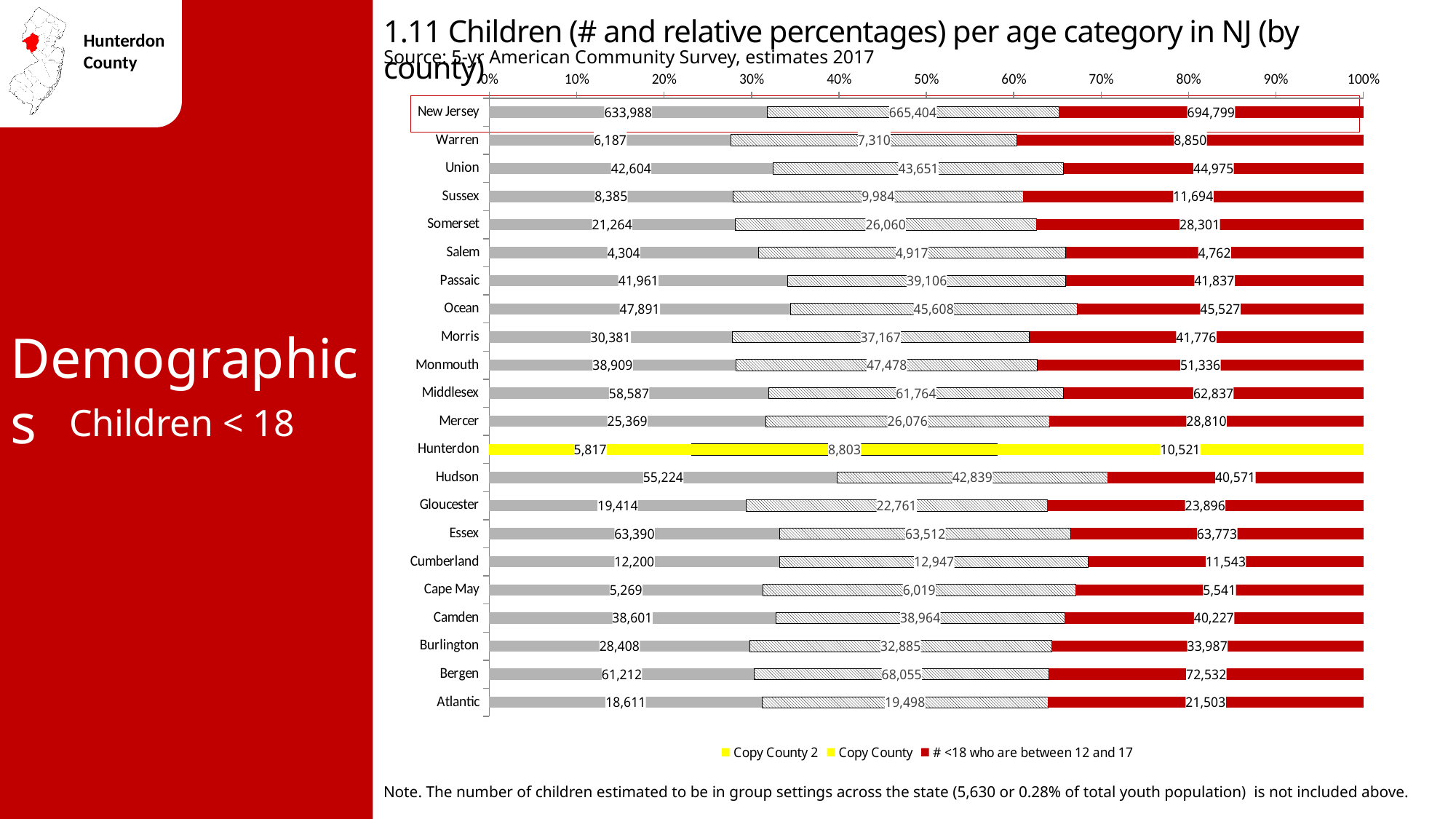
What is the value of the first (leftmost) segment of the Hunterdon bar? 5,817 What is the difference between Hunterdon's 12-to-17 value and its leftmost segment value? 4,704 How many bars (counties plus the state total) are shown in the chart? 22 Is the leftmost segment of the Warren bar greater or less than 30% of the bar? less What is the number of children under 18 who are between 12 and 17 in Hunterdon? 10,521 What is the value of the middle segment of the Bergen bar? 68,055 Among the counties (excluding the New Jersey total), which has the lowest number of children between 12 and 17? Salem What is the total of the three segments of the Hunterdon bar? 25,141 Among the counties (excluding the New Jersey total), which has the highest number of children between 12 and 17? Bergen What is the number of children under 18 who are between 12 and 17 for New Jersey as a whole? 694,799 Which is larger: the leftmost segment value for Hudson or for Essex? Essex How many series does the legend list? 3